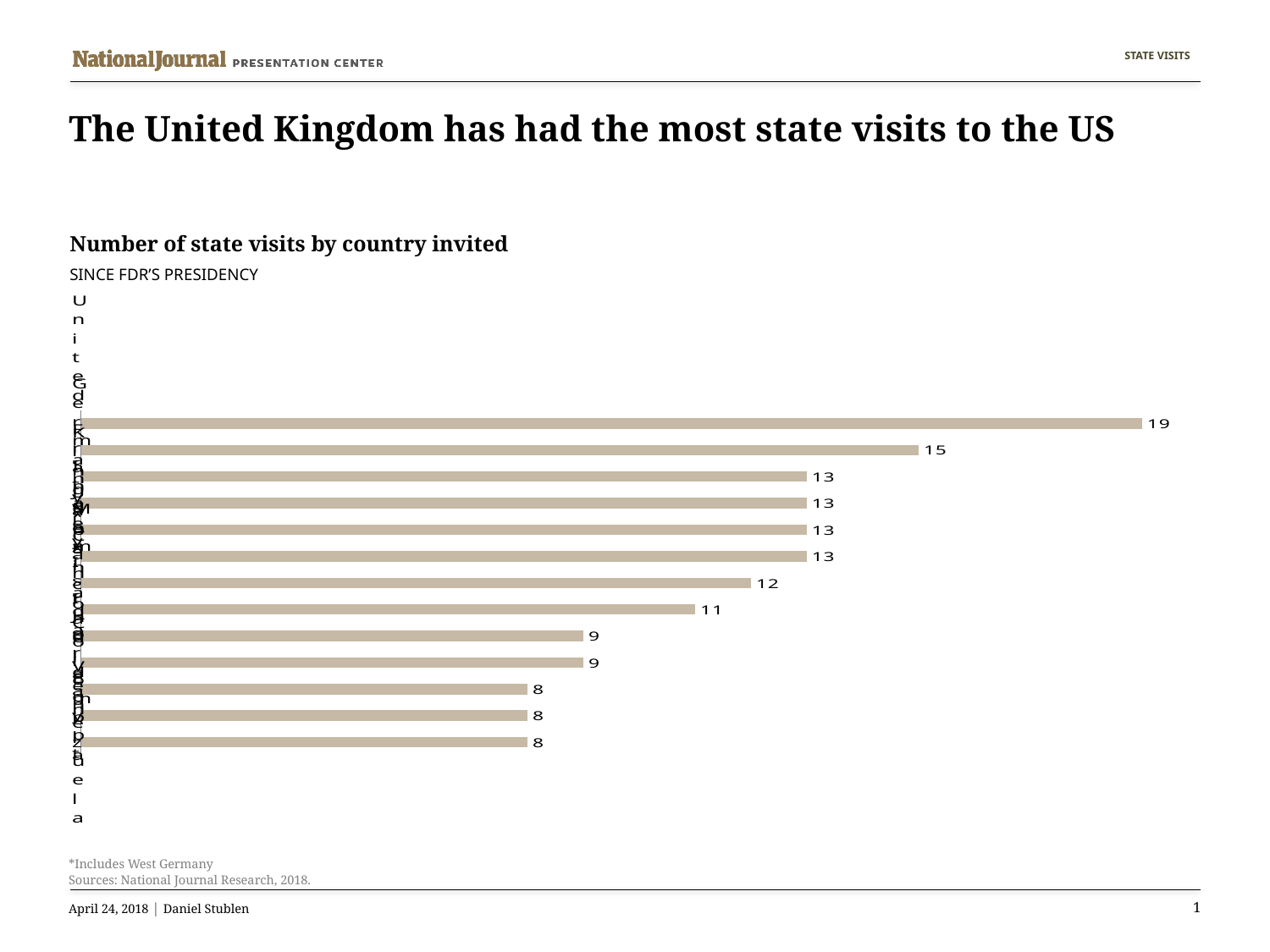
How many bars are plotted in the chart? 13 What is the highest value shown in the chart? 19 What is the value of the seventh bar from the top? 12 What is the difference between the longest bar and the second-longest bar? 4 What is the title of the chart? Number of state visits by country invited What is the value of the second bar from the top? 15 How many bars in the chart have a value of 13? 4 What kind of chart is shown on the slide? bar chart What subtitle appears directly below the chart title? SINCE FDR'S PRESIDENCY How many bars in the chart have a value of 8? 3 What is the lowest value shown in the chart? 8 What is the difference between the longest bar and the shortest bar in the chart? 11